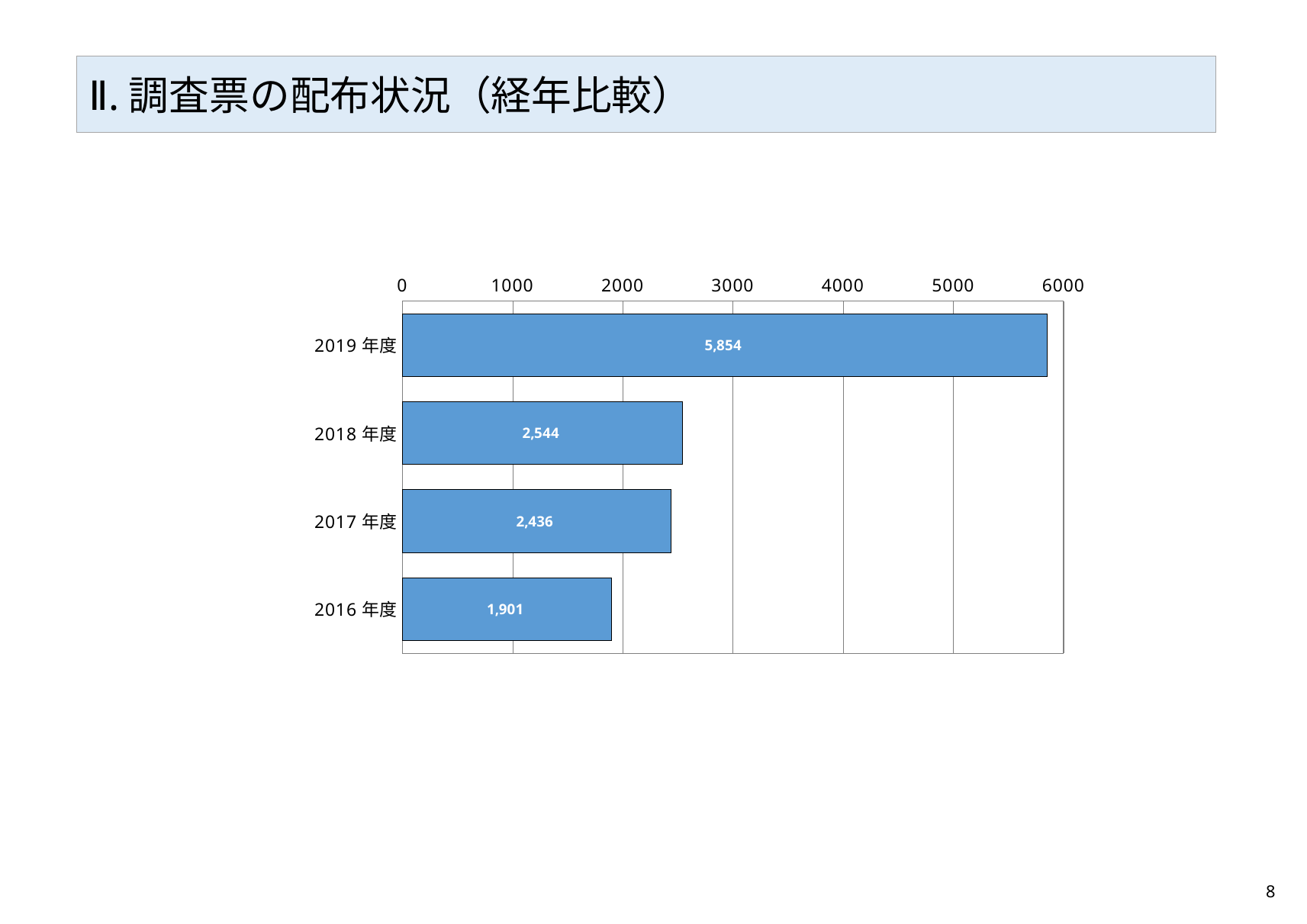
Which year has the highest value? 2019 年度 Which year has the lowest value? 2016 年度 What is the value for 2019 年度? 5,854 Is the value for 2016 年度 greater or less than 2000? less Which is larger, the value for 2018 年度 or 2017 年度? 2018 年度 What is the value for 2016 年度? 1,901 What is the difference between the values for 2017 年度 and 2016 年度? 535 What kind of chart is shown on the slide? bar chart What is the value for 2017 年度? 2,436 What is the difference between the values for 2019 年度 and 2018 年度? 3,310 How many years are shown in the chart? 4 What is the value for 2018 年度? 2,544